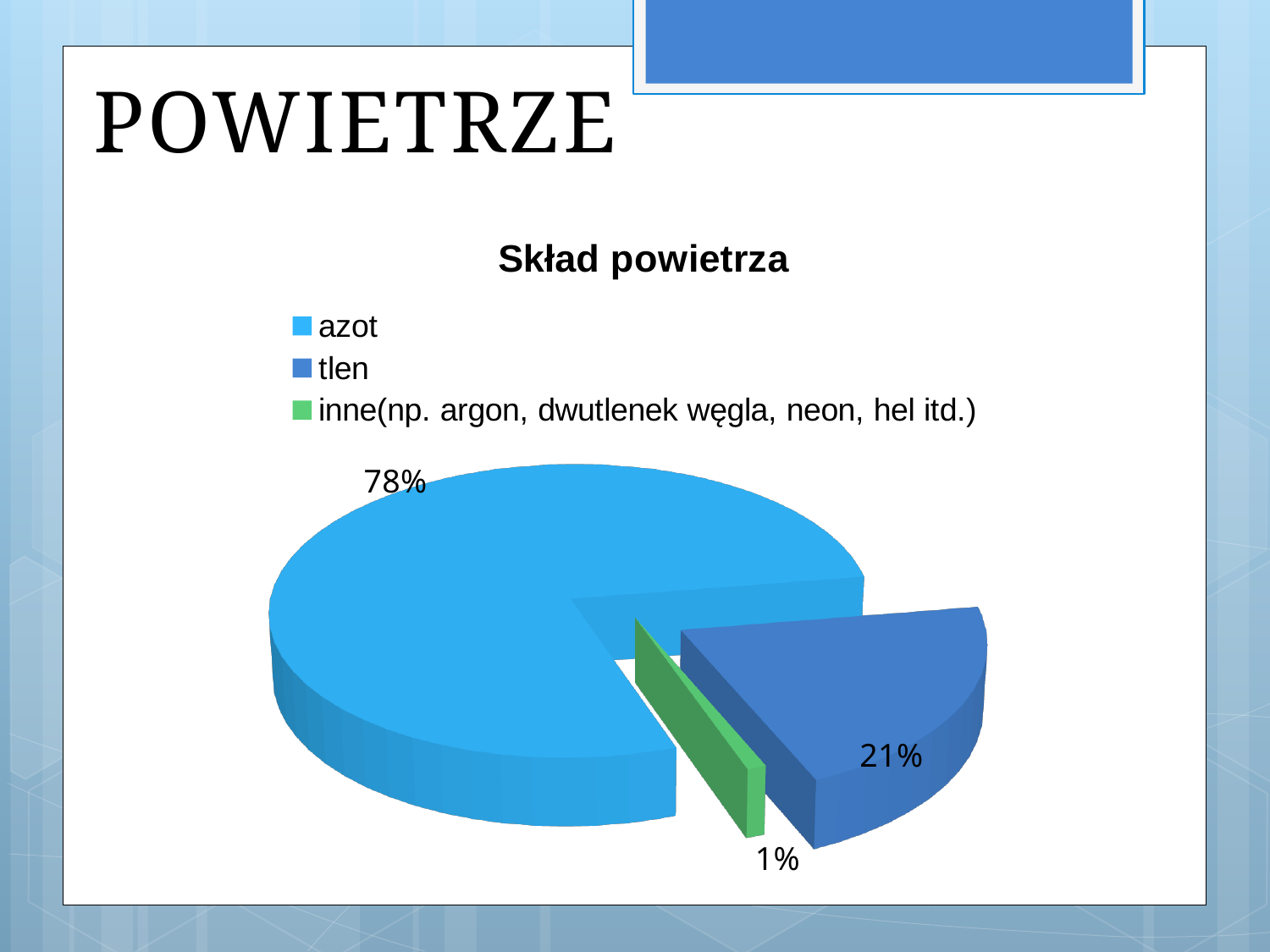
What share of the pie does inne(np. argon, dwutlenek węgla, neon, hel itd.) have? 1% How many categories does the pie chart show? 3 What share of the pie does tlen have? 21% What is the difference in percentage points between azot and tlen? 57 What is the title of the chart? Skład powietrza How many entries does the legend list? 3 What is the difference in percentage points between tlen and inne? 20 What kind of chart is shown on the slide? pie chart Which category has the smallest slice of the pie? inne(np. argon, dwutlenek węgla, neon, hel itd.) What share of the pie does azot have? 78% Which is larger, the slice for tlen or the slice for inne? tlen Which category has the largest slice of the pie? azot